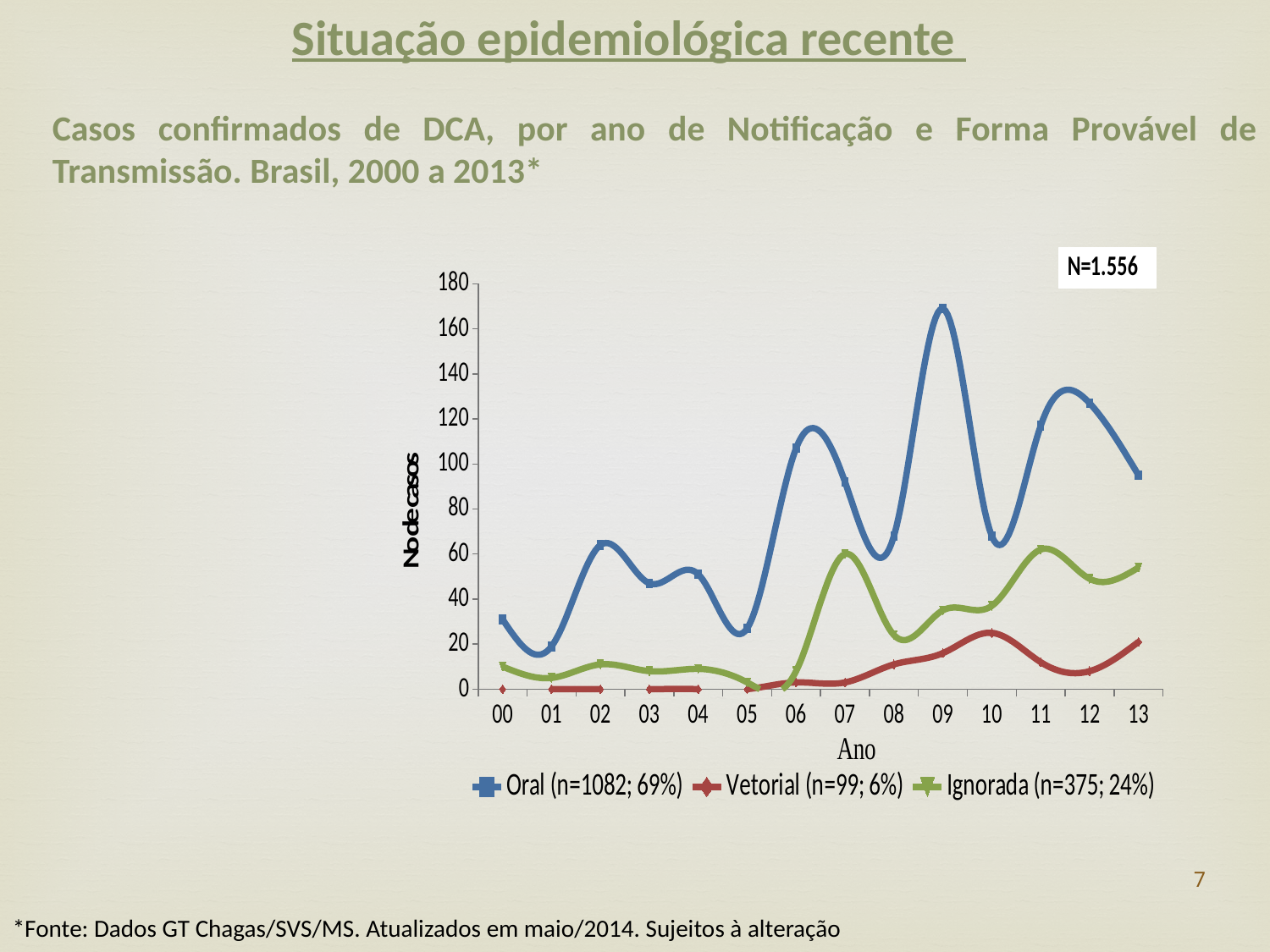
Which series has the higher value in 13, Vetorial or Ignorada? Ignorada What percentage is given for the Oral series in the legend? 69% In which year does the Oral series reach its highest value? 09 Which series has the higher value in 09, Oral or Ignorada? Oral What kind of chart is shown on the slide? line chart How many years are shown along the x axis? 14 Is the value for Vetorial in 10 greater or less than 20? greater What total N is shown in the box at the top right of the chart? N=1.556 How many series does the legend list? 3 In which year does the Vetorial series reach its highest value? 10 Is the value for Oral in 13 greater or less than 100? less Is the value for Oral in 09 greater or less than 160? greater